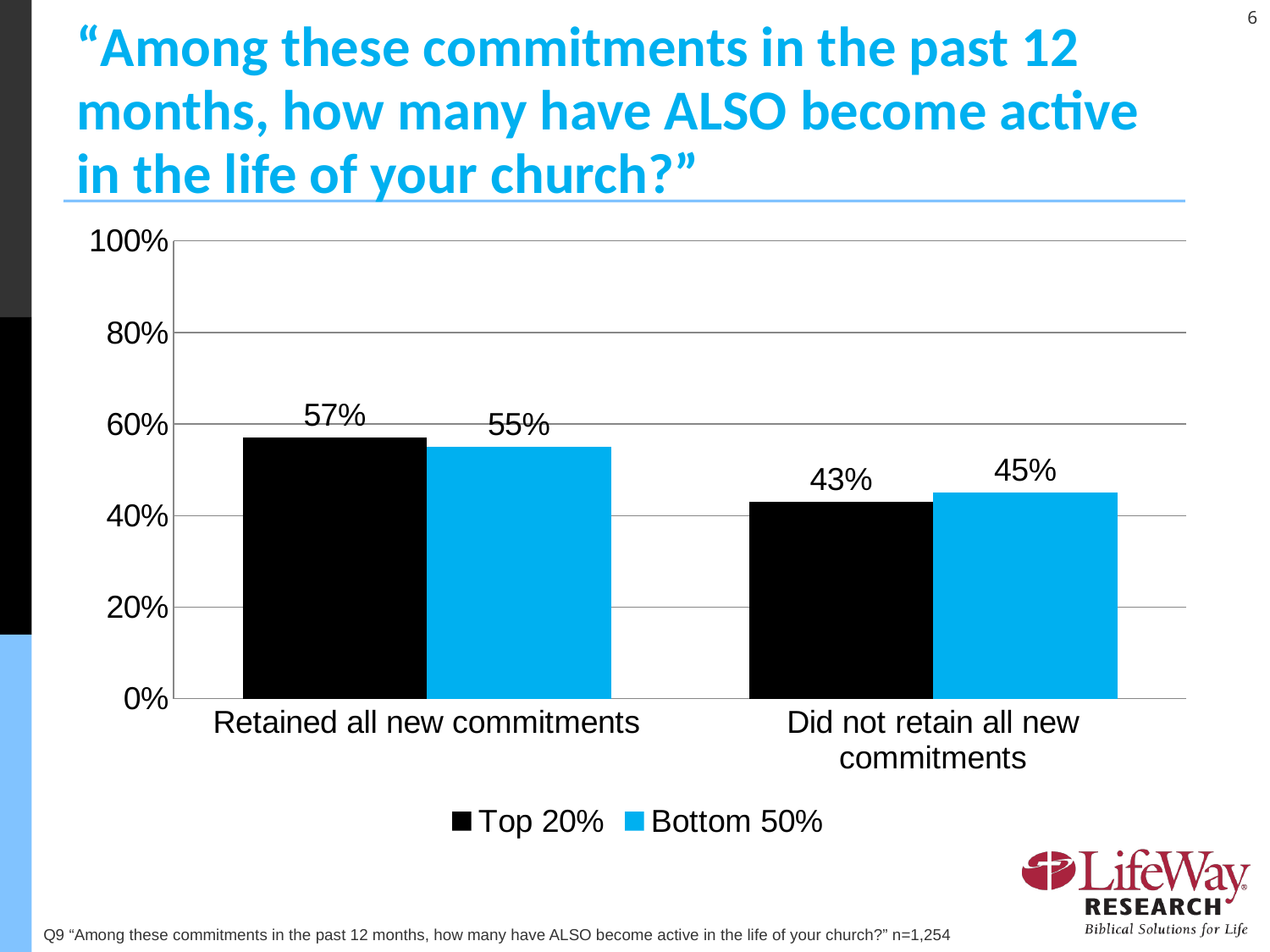
What is the value for Bottom 50% in the 'Did not retain all new commitments' category? 45% Is the Top 20% value for 'Retained all new commitments' greater or less than 40%? greater What kind of chart is shown on the slide? Bar chart Which category has the highest value for the Top 20% series? Retained all new commitments What is the value for Top 20% in the 'Did not retain all new commitments' category? 43% Which category has the lowest value for the Bottom 50% series? Did not retain all new commitments What is the difference between the Top 20% values for 'Retained all new commitments' and 'Did not retain all new commitments'? 14 percentage points What is the value for Top 20% in the 'Retained all new commitments' category? 57% How many categories are shown on the x axis? 2 What is the difference between the Top 20% and Bottom 50% values in the 'Retained all new commitments' category? 2 percentage points How many series does the legend list? 2 What is the value for Bottom 50% in the 'Retained all new commitments' category? 55%